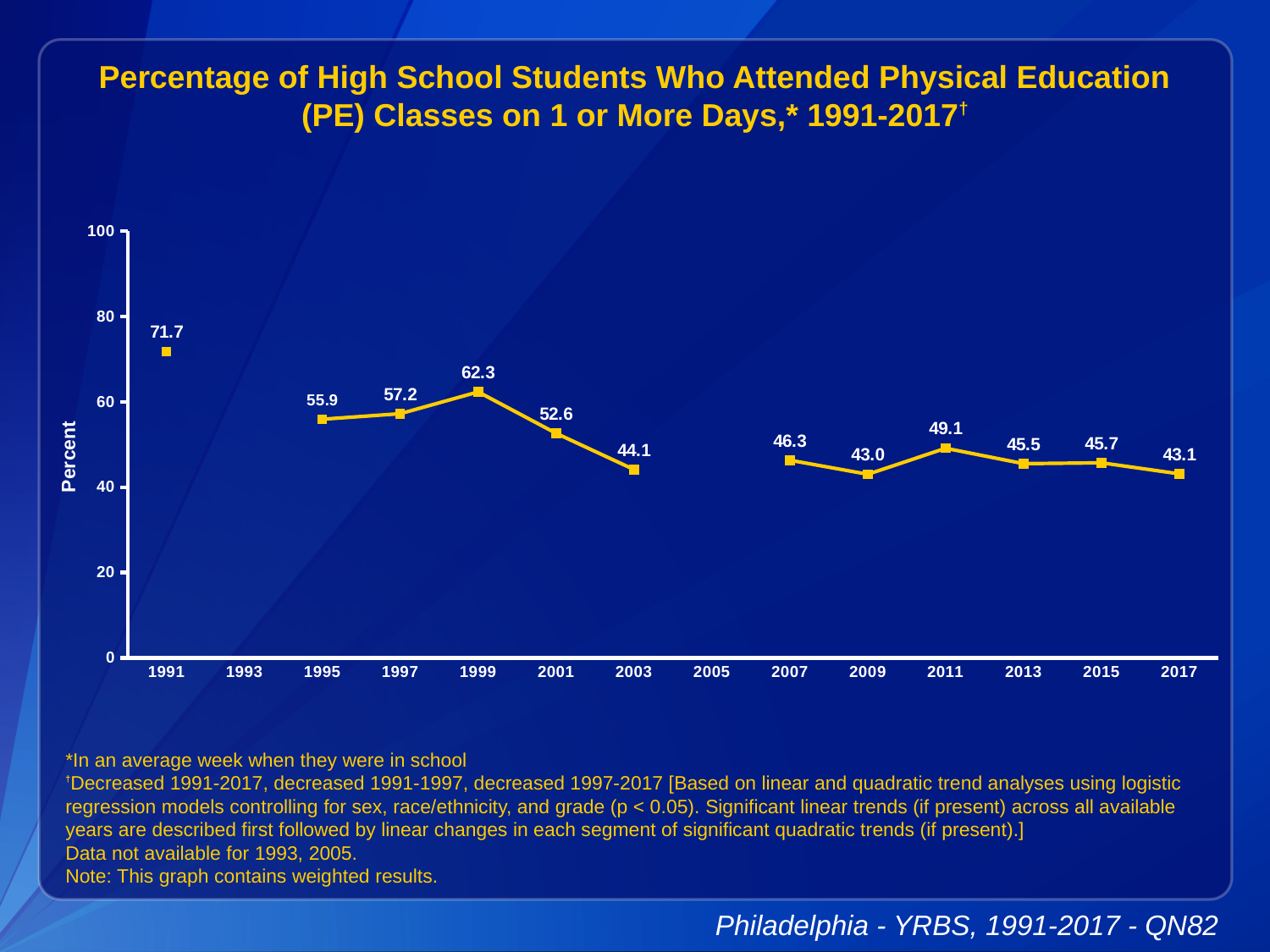
What value is plotted for 1999? 62.3 Which year has a larger value, 1997 or 2003? 1997 What was the percentage of high school students who attended PE classes on 1 or more days in 1991? 71.7 Do the plotted values generally rise or fall from 1991 to 2017? fall What is the difference between the 1991 value and the 2017 value? 28.6 What value is plotted for 2017? 43.1 Which year has the lowest plotted value? 2009 What is the label on the y axis? Percent Which year has the highest plotted value? 1991 What kind of chart is shown on the slide? line chart Is the value for 2011 greater or less than 60? less How many years have data points plotted on the chart? 12